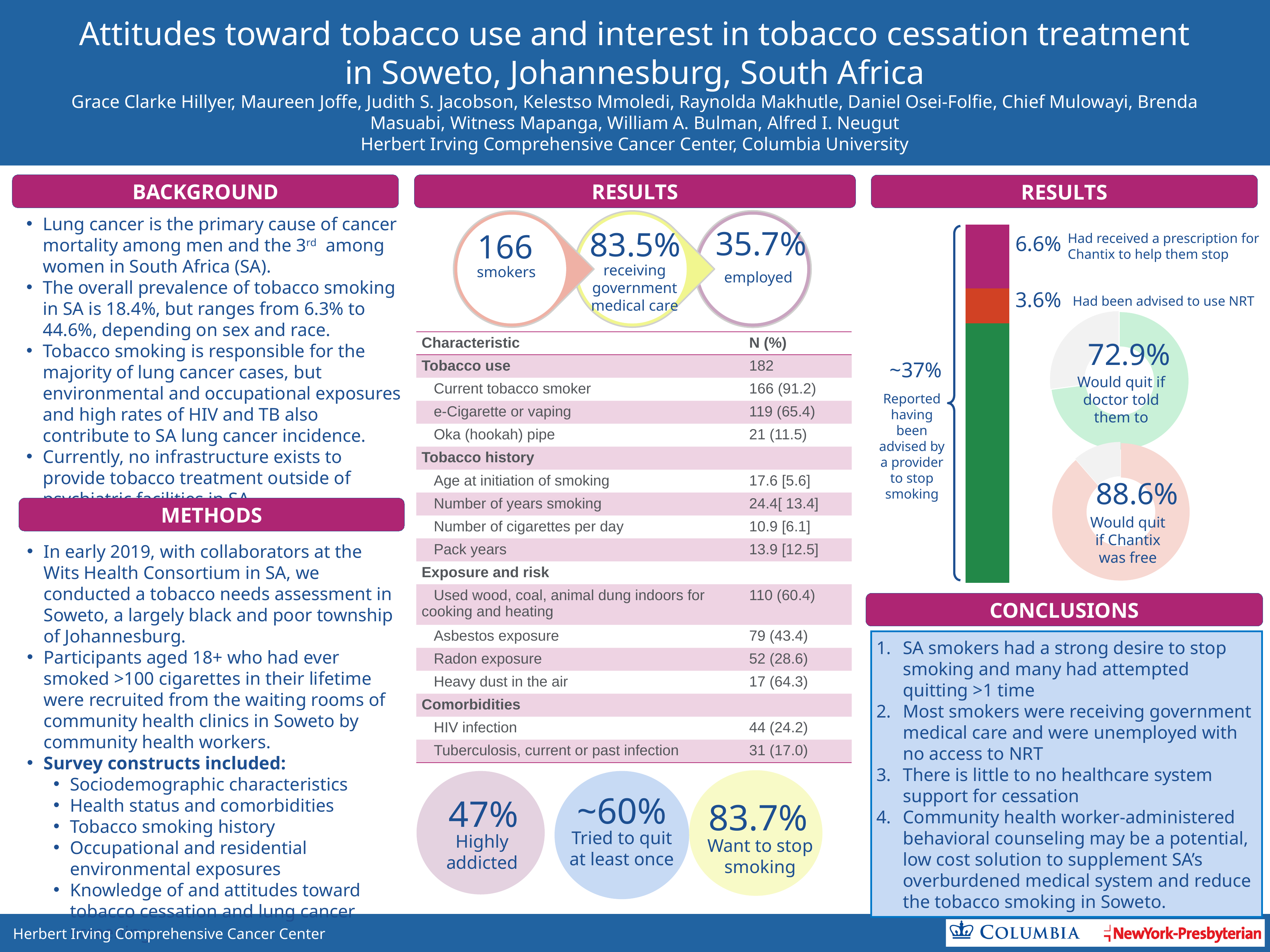
What kind of chart is used to show the 72.9% and 88.6% values on the right side of the slide? Pie (donut) chart In the stacked bar chart, what percentage had been advised to use NRT? 3.6% How many coloured segments does the stacked bar in the right-hand RESULTS section have? 3 In the lower donut chart, what percentage would quit if Chantix was free? 88.6% In the stacked bar chart, which is larger: the share who had received a Chantix prescription or the share advised to use NRT? Received a Chantix prescription (6.6%) What kind of chart is the tall green, orange and magenta graphic in the right-hand RESULTS section? Stacked bar chart In the stacked bar chart, what is the difference between the share who received a Chantix prescription (6.6%) and the share advised to use NRT (3.6%)? 3.0% Which is larger: the share who would quit if a doctor told them to, or the share who would quit if Chantix was free? Would quit if Chantix was free (88.6%) What is the difference between the share who would quit if Chantix was free (88.6%) and the share who would quit if a doctor told them to (72.9%)? 15.7% In the upper donut chart, what percentage would quit if a doctor told them to? 72.9% What colour is the segment of the stacked bar labelled 6.6% (received a Chantix prescription)? Magenta In the stacked bar chart, what percentage had received a prescription for Chantix to help them stop? 6.6%